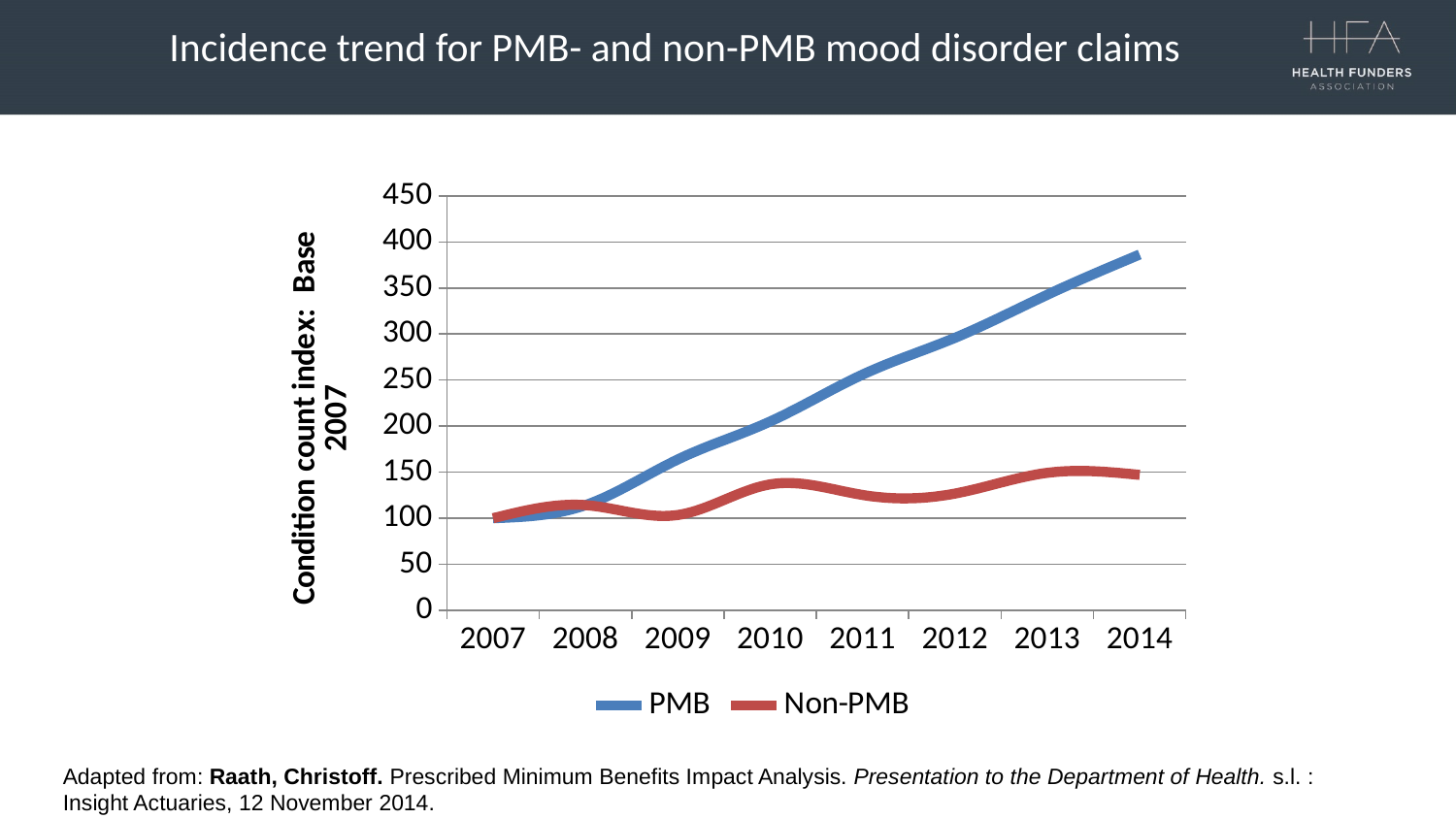
Is the Non-PMB value for 2014 greater or less than 200? less Which series has the larger value in 2014, PMB or Non-PMB? PMB Is the PMB value for 2013 greater or less than 300? greater In which year is the PMB value highest? 2014 How many years are shown on the x axis? 8 What is the label on the y axis? Condition count index: Base 2007 Is the PMB value for 2014 greater or less than 350? greater What kind of chart is shown on the slide? line chart Does the PMB line rise or fall from 2007 to 2014? rise What is the title of the chart? Incidence trend for PMB- and non-PMB mood disorder claims In which year is the PMB value lowest? 2007 How many series does the legend list? 2